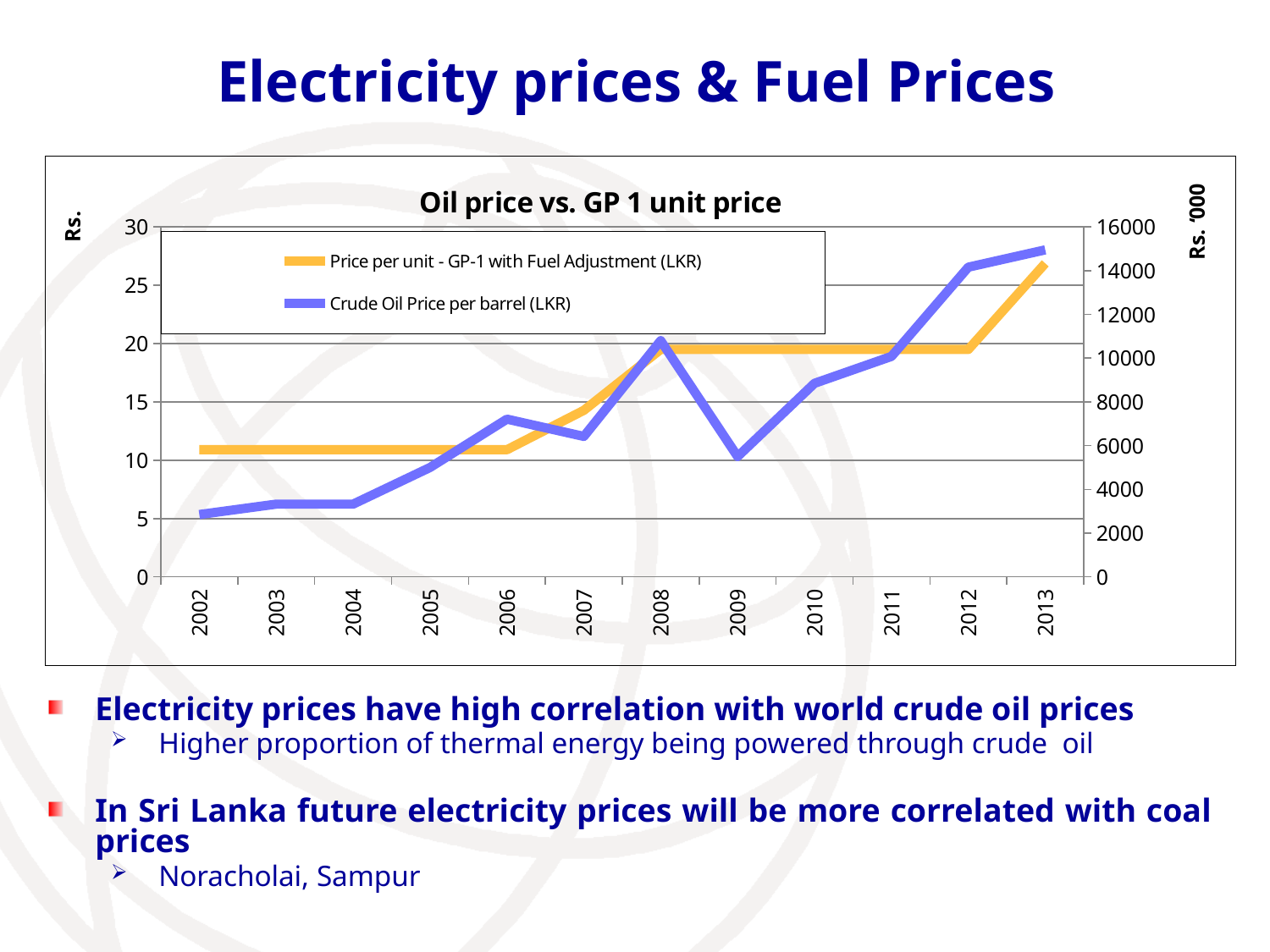
Is the Crude Oil Price per barrel (LKR) in 2009 greater or less than 6000? less Is the Crude Oil Price per barrel (LKR) in 2002 greater or less than 4000? less Is the Crude Oil Price per barrel (LKR) in 2008 greater or less than 10000? greater In which year is the Crude Oil Price per barrel (LKR) highest? 2013 How many series does the chart's legend list? 2 What kind of chart is shown on the slide? Line chart Which series is drawn in blue in the chart? Crude Oil Price per barrel (LKR) In which year is the Crude Oil Price per barrel (LKR) lowest? 2002 What is the title of the chart? Oil price vs. GP 1 unit price How many years are plotted along the x axis of the chart? 12 Does the Price per unit - GP-1 with Fuel Adjustment (LKR) rise or fall overall from 2002 to 2013? Rise